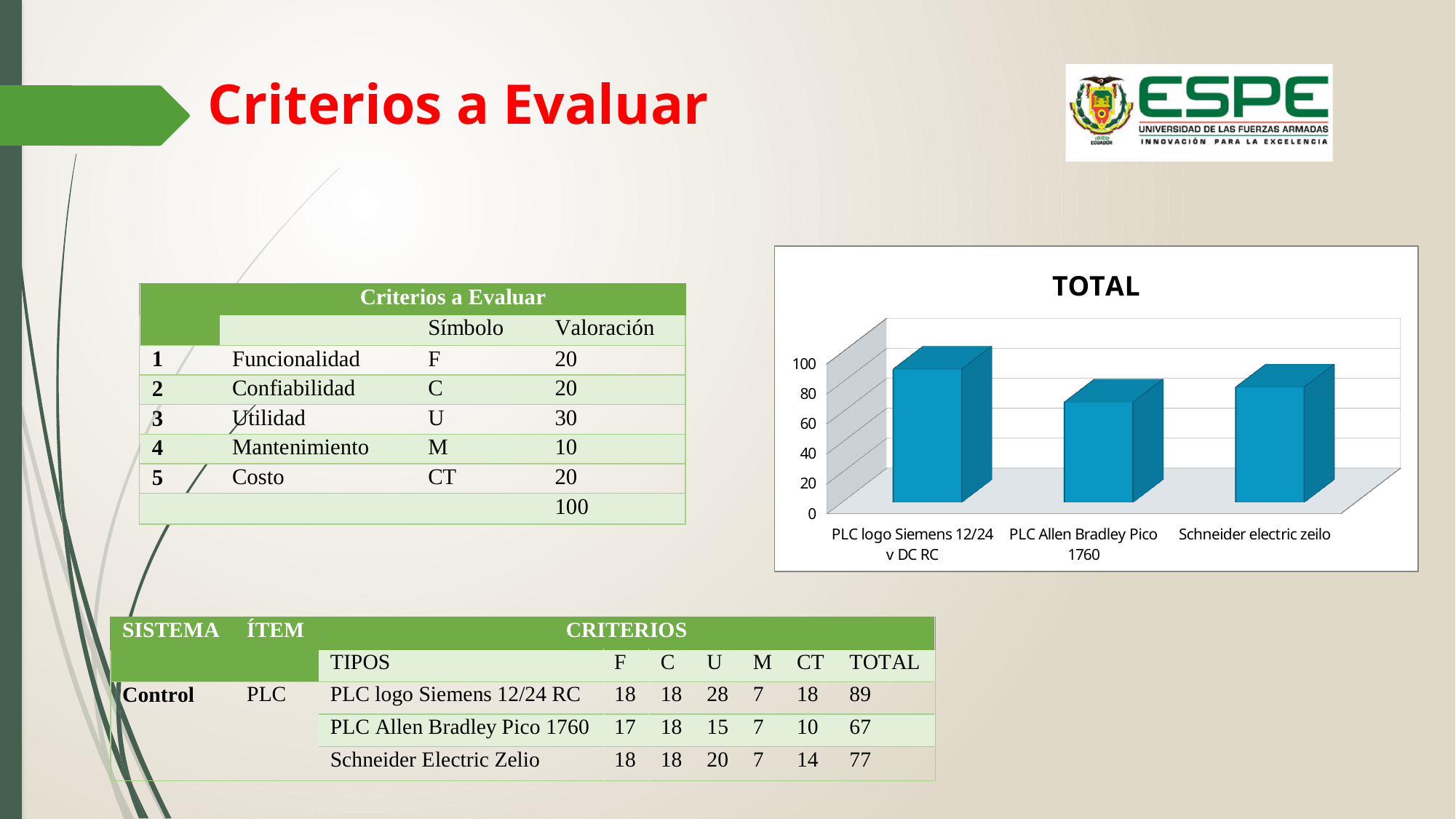
Which is larger in the TOTAL chart, Schneider electric zeilo or PLC Allen Bradley Pico 1760? Schneider electric zeilo What is the title of the chart? TOTAL Which category has the highest bar in the TOTAL chart? PLC logo Siemens 12/24 v DC RC Is the value for PLC logo Siemens 12/24 v DC RC greater or less than 80? greater Is the value for PLC Allen Bradley Pico 1760 greater or less than 80? less Which is larger in the TOTAL chart, PLC logo Siemens 12/24 v DC RC or PLC Allen Bradley Pico 1760? PLC logo Siemens 12/24 v DC RC What is the highest tick value shown on the vertical axis of the TOTAL chart? 100 Which category has the lowest bar in the TOTAL chart? PLC Allen Bradley Pico 1760 Is the value for Schneider electric zeilo greater or less than 60? greater What kind of chart is shown on the slide? bar chart How many categories are plotted in the TOTAL chart? 3